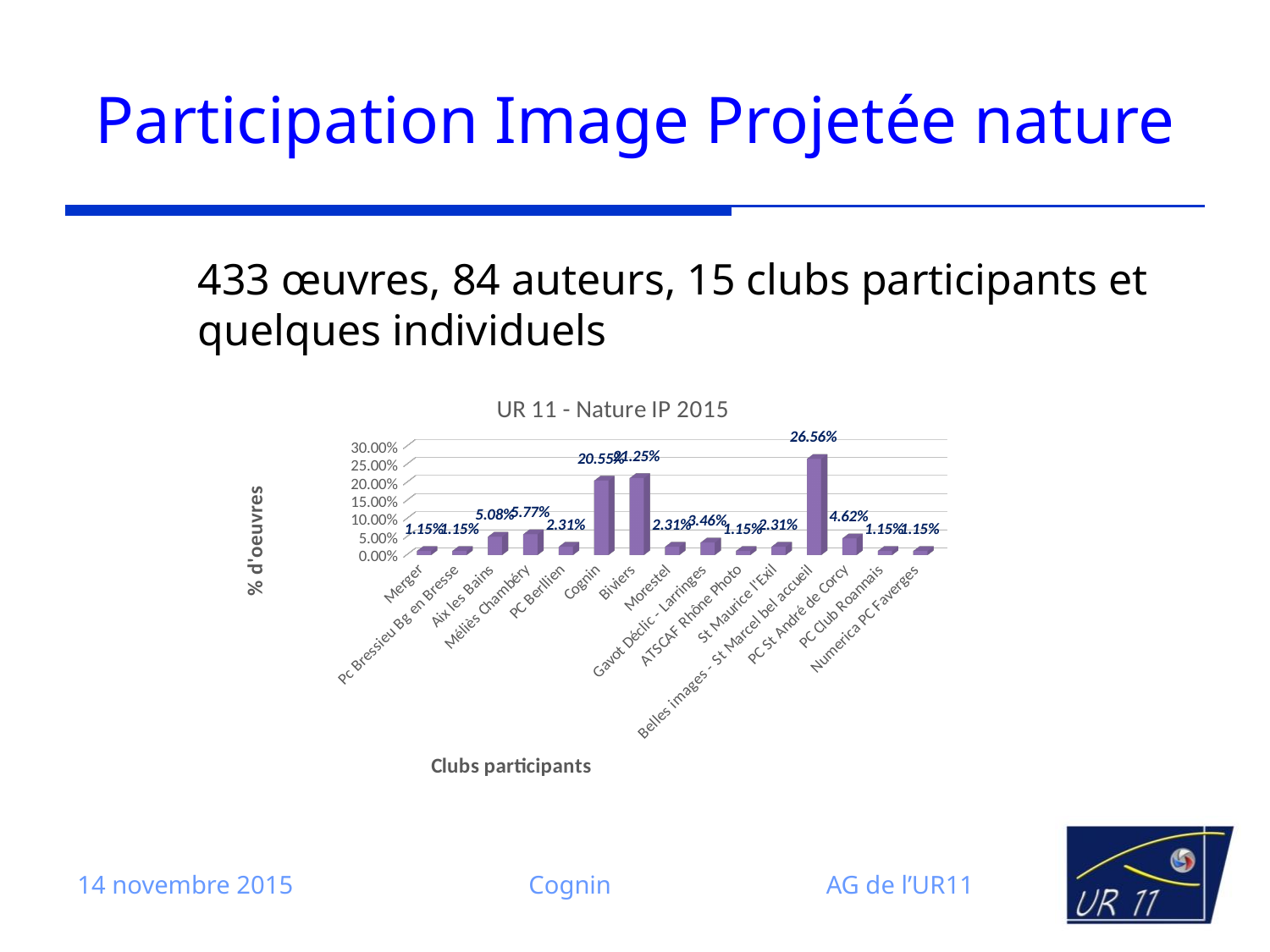
What is the value for PC St André de Corcy? 4.62% Is the value for Cognin greater or less than 15.00%? greater What is the difference between the values for Biviers and Cognin? 0.70% What is the value for Aix les Bains? 5.08% What kind of chart is shown on the slide? bar chart What is the title of the chart? UR 11 - Nature IP 2015 What is the difference between the values for Belles images - St Marcel bel accueil and Biviers? 5.31% What percentage of works is shown for Méliès Chambéry? 5.77% Which has a larger value, Gavot Déclic - Larringes or Morestel? Gavot Déclic - Larringes What is the value for Belles images - St Marcel bel accueil in the chart? 26.56% How many clubs are shown on the x axis of the chart? 15 Which club has the highest percentage of works in the chart? Belles images - St Marcel bel accueil